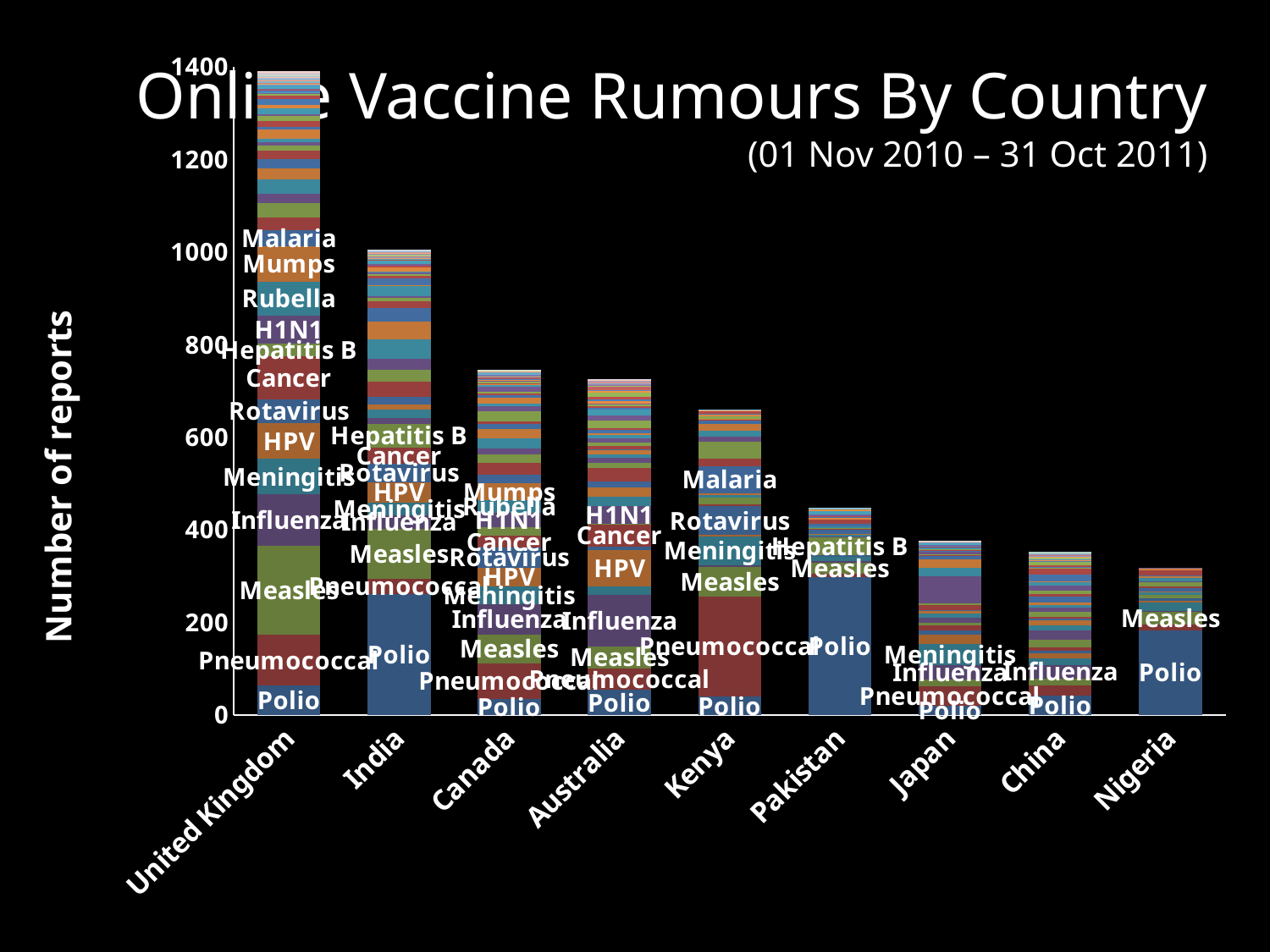
Do the total reports rise or fall moving from left to right across the countries? Fall Is the total number of reports for India greater or less than 800? greater Is the total number of reports for the United Kingdom greater or less than 1200? greater Which country has more reports, Kenya or Pakistan? Kenya Which country has the highest number of online vaccine rumour reports? United Kingdom How many countries are shown on the x axis of the chart? 9 What is the title of the chart? Online Vaccine Rumours By Country Is the total number of reports for Pakistan greater or less than 600? less Which country has more reports, India or Canada? India What is the label on the y axis of the chart? Number of reports What type of chart is shown on the slide? Stacked bar chart